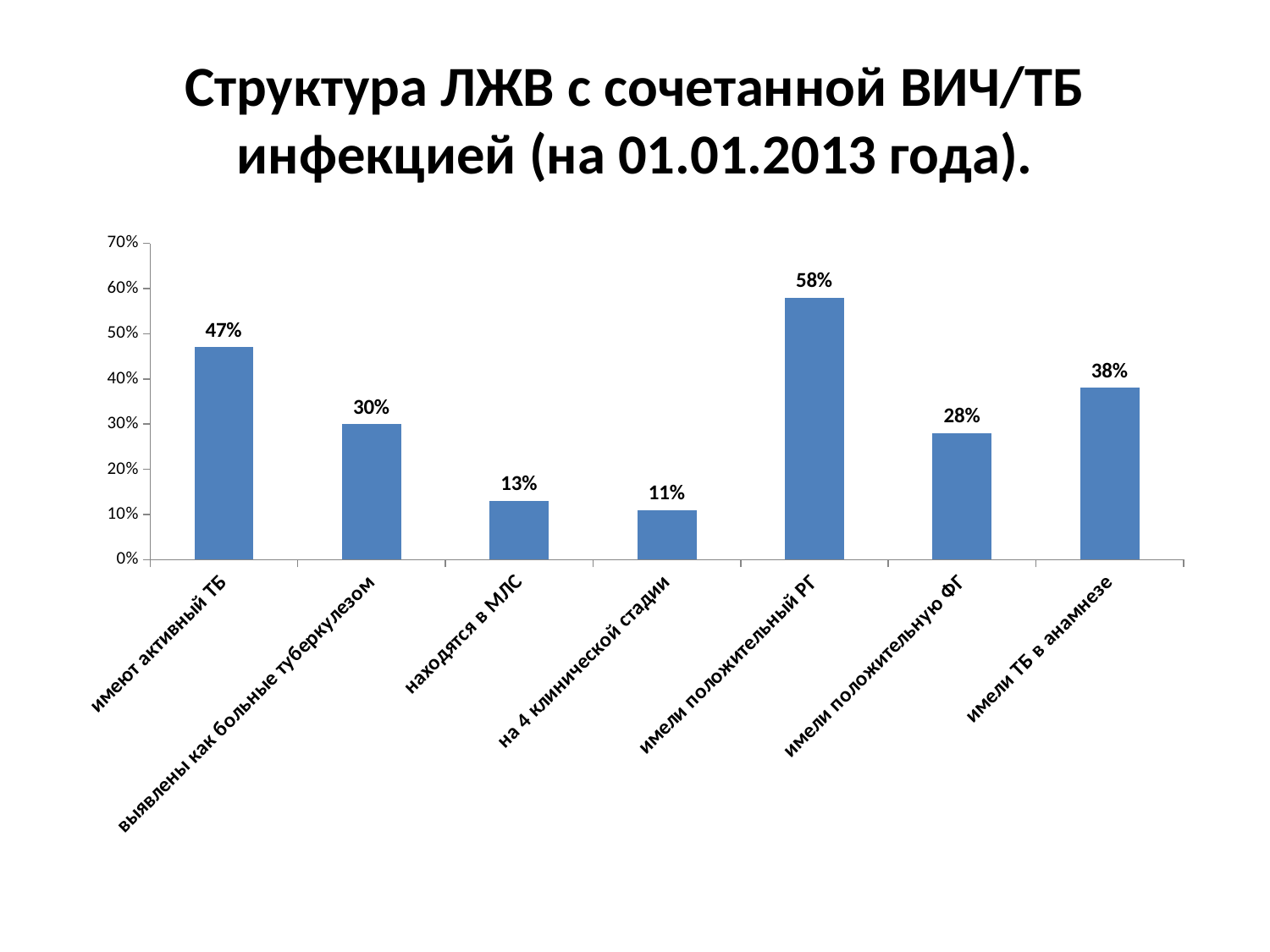
How many categories are shown in the chart? 7 Is the value for "имели ТБ в анамнезе" greater or less than 30%? greater What is the value for "имеют активный ТБ"? 47% What is the title of the chart on the slide? Структура ЛЖВ с сочетанной ВИЧ/ТБ инфекцией (на 01.01.2013 года). What kind of chart is shown on the slide? bar chart What is the value for "находятся в МЛС"? 13% Which category has the highest value? имели положительный РГ What is the difference between "имели положительный РГ" and "имели ТБ в анамнезе"? 20% Which category has the lowest value? на 4 клинической стадии Which is larger: "выявлены как больные туберкулезом" or "имели положительную ФГ"? выявлены как больные туберкулезом What is the value for "имели положительную ФГ"? 28% What is the difference between "имеют активный ТБ" and "выявлены как больные туберкулезом"? 17%